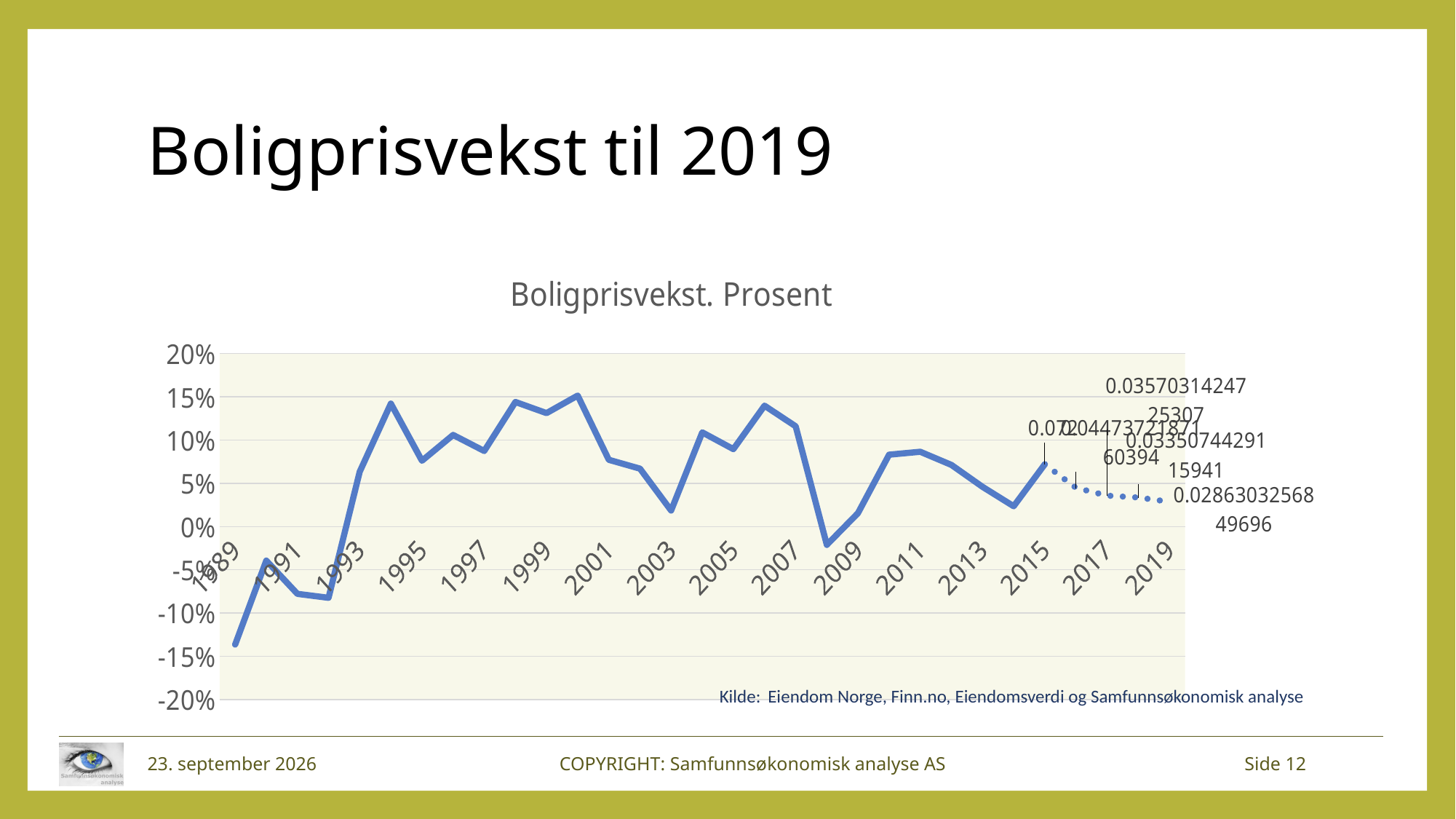
How many year labels are shown on the x axis? 16 What is the title of the chart? Boligprisvekst. Prosent Which year has the larger value, 1991 or 1993? 1993 Which year has the highest value on the chart? 2000 Is the value for 2008 greater or less than 0%? less Is the value for 2003 greater or less than 5%? less What kind of chart is shown on the slide? Line chart Is the value for 1994 greater or less than 10%? greater Do the values rise or fall from 2015 to 2019? fall Which year has the lowest value on the chart? 1989